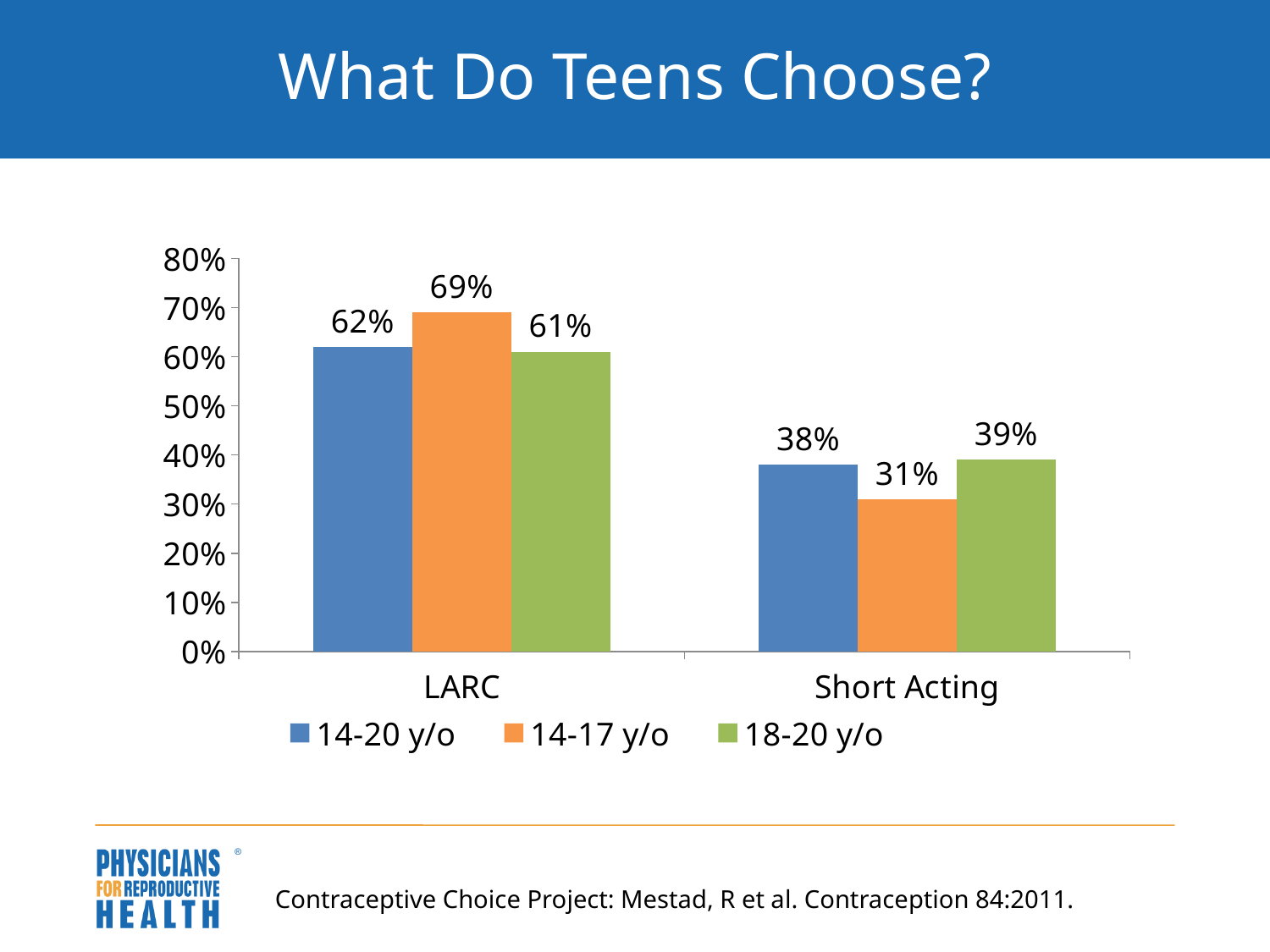
How many categories are shown on the x axis? 2 What percentage of 14-17 year olds chose LARC? 69% What is the value for the 18-20 y/o series in the Short Acting category? 39% Which age group has the highest value for LARC? 14-17 y/o What is the difference between the 14-17 y/o values for LARC and Short Acting? 38% What percentage of 14-20 year olds chose Short Acting methods? 38% How many series does the legend list? 3 What is the title of the slide? What Do Teens Choose? What kind of chart is shown on the slide? Bar chart Which age group has the lowest value for Short Acting? 14-17 y/o Which is larger: the 14-20 y/o value for LARC or the 14-20 y/o value for Short Acting? LARC What is the difference between the 14-20 y/o and 18-20 y/o values for LARC? 1%